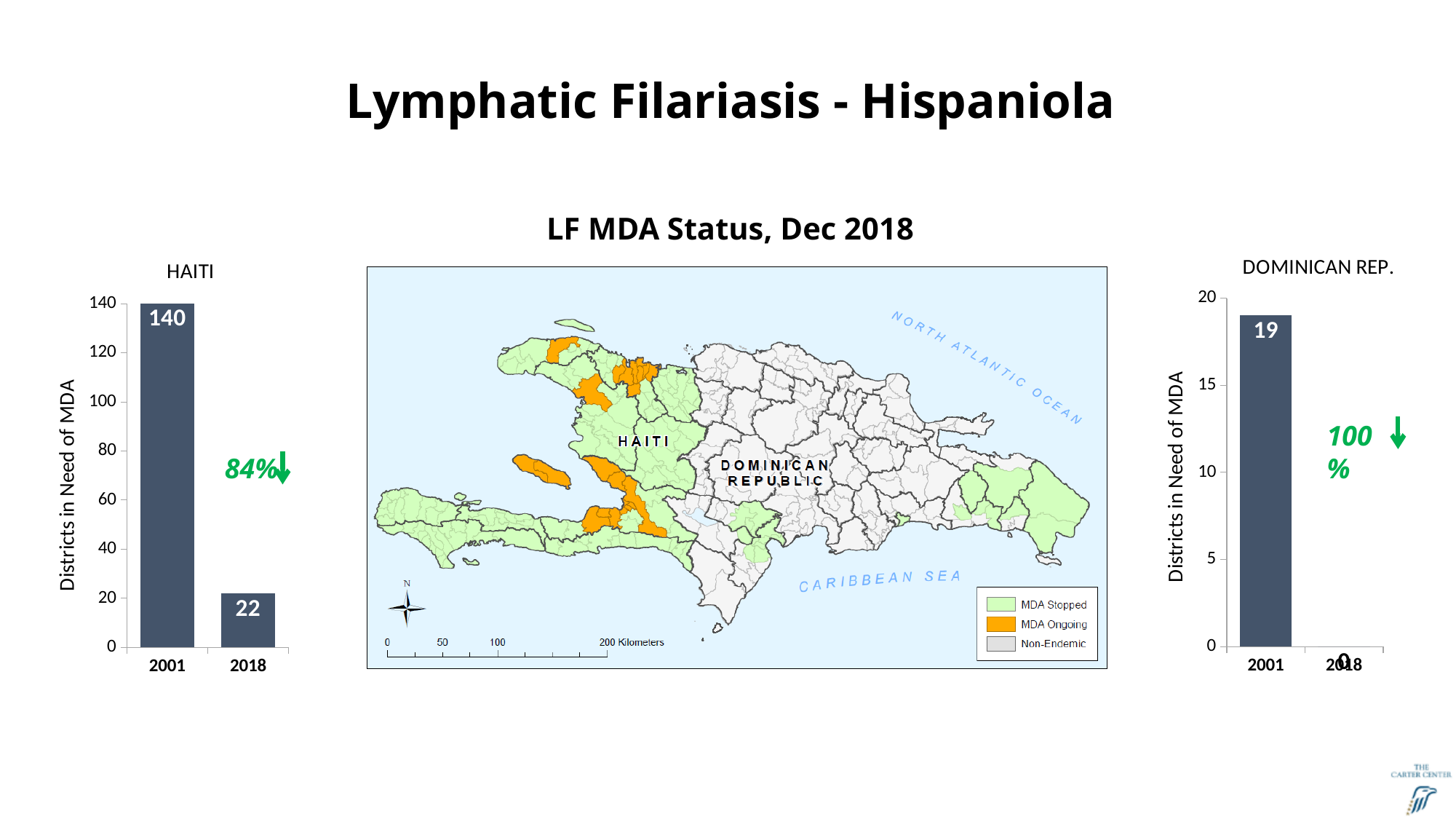
In the DOMINICAN REP. chart, which year has the lowest value? 2018 In the HAITI chart, do the values rise or fall from 2001 to 2018? fall In the DOMINICAN REP. chart, what is the value for 2001? 19 In the HAITI chart, what is the difference between the 2001 and 2018 values? 118 How many categories are shown on the x axis of the HAITI chart? 2 In the HAITI chart, is the value for 2018 greater or less than 40? less In the HAITI chart, which year has the higher value, 2001 or 2018? 2001 What kind of chart is the DOMINICAN REP. chart? bar chart In the DOMINICAN REP. chart, is the value for 2001 greater or less than 15? greater In the HAITI chart, what is the value for 2018? 22 In the HAITI chart, what is the value for 2001? 140 What is the y-axis label of the HAITI chart? Districts in Need of MDA